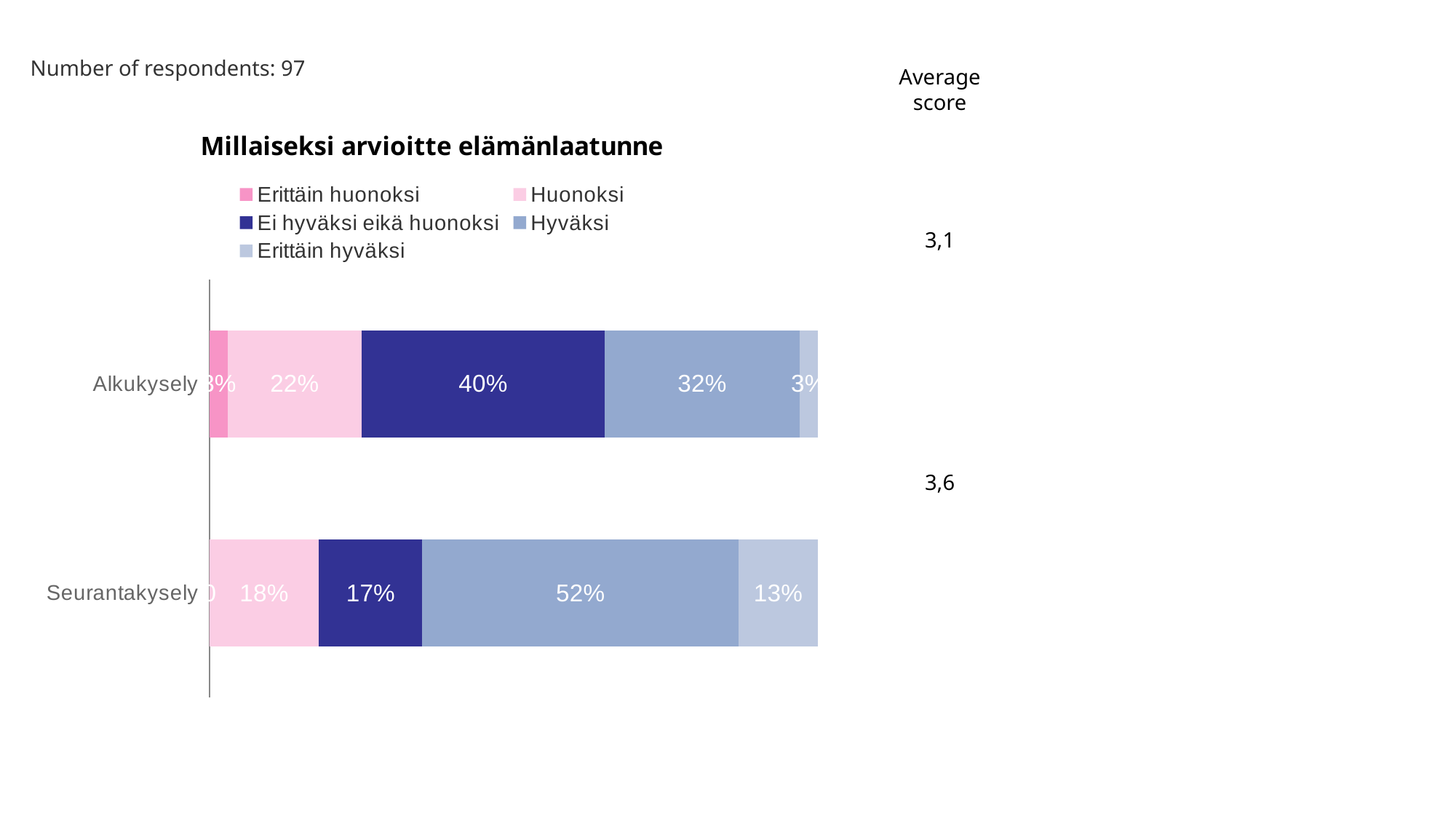
What is the value for Huonoksi in the Alkukysely bar? 22% What is the value for Ei hyväksi eikä huonoksi in the Alkukysely bar? 40% Which series has the largest share in the Alkukysely bar? Ei hyväksi eikä huonoksi Which category has the larger value for Hyväksi, Alkukysely or Seurantakysely? Seurantakysely How many series does the legend list? 5 What is the average score shown for Seurantakysely? 3,6 What is the title of the chart? Millaiseksi arvioitte elämänlaatunne What kind of chart is shown on the slide? Stacked bar chart What is the value for Hyväksi in the Seurantakysely bar? 52% What is the value for Erittäin hyväksi in the Seurantakysely bar? 13% How many categories are shown on the chart? 2 What is the difference between the Hyväksi values for Seurantakysely and Alkukysely? 20%